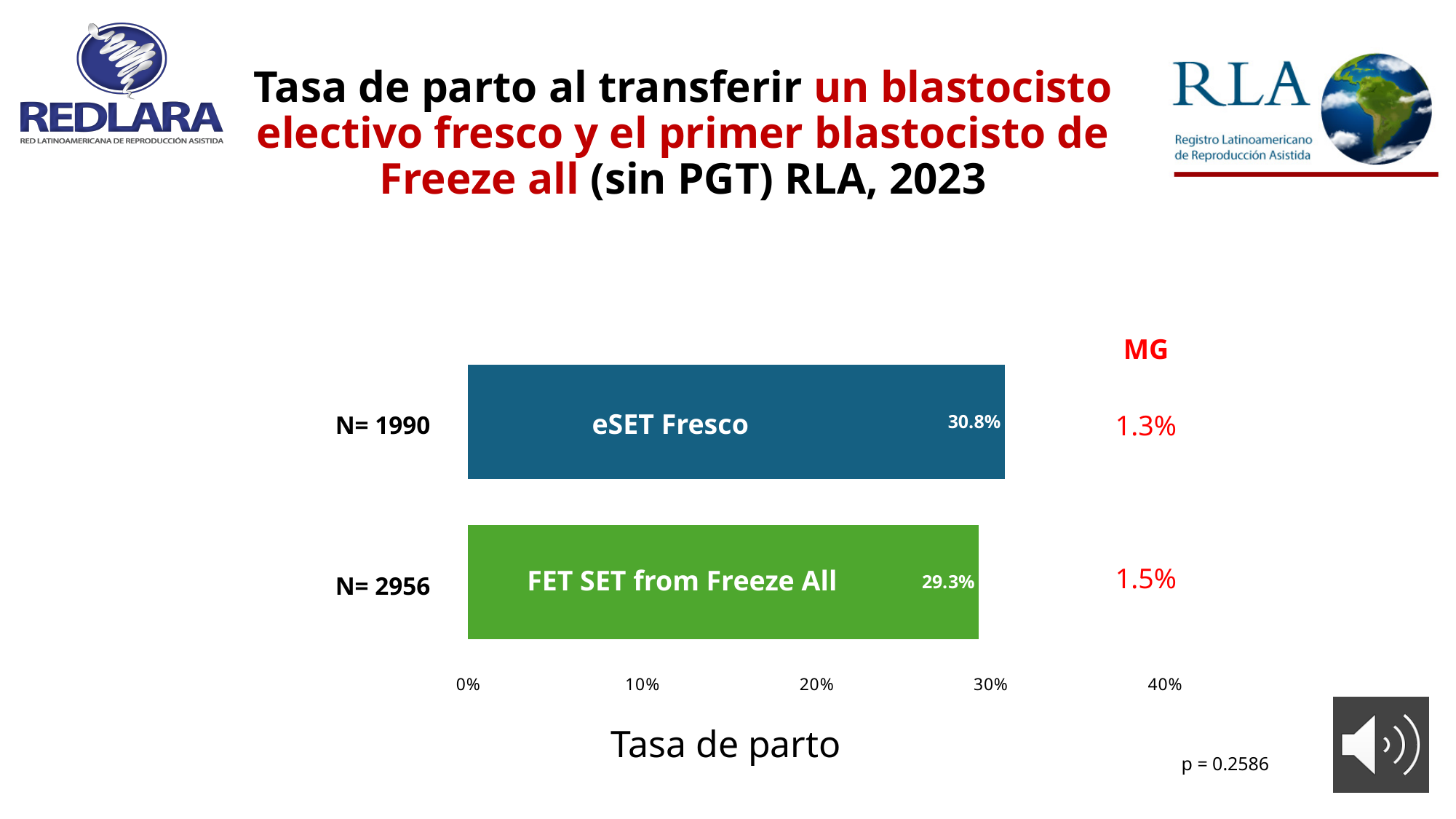
Which category has the lowest delivery rate? FET SET from Freeze All What is the delivery rate (Tasa de parto) for eSET Fresco? 30.8% Is the delivery rate for eSET Fresco greater or less than 30%? greater What kind of chart is shown on the slide? Bar chart What is the delivery rate (Tasa de parto) for FET SET from Freeze All? 29.3% Is the delivery rate for FET SET from Freeze All greater or less than 30%? less What is the MG value shown for FET SET from Freeze All? 1.5% What is the difference in delivery rate between eSET Fresco and FET SET from Freeze All? 1.5 percentage points How many categories (bars) are shown in the chart? 2 What is the N (sample size) shown for eSET Fresco? N= 1990 Which category has the higher delivery rate, eSET Fresco or FET SET from Freeze All? eSET Fresco What is the label of the x axis of the chart? Tasa de parto